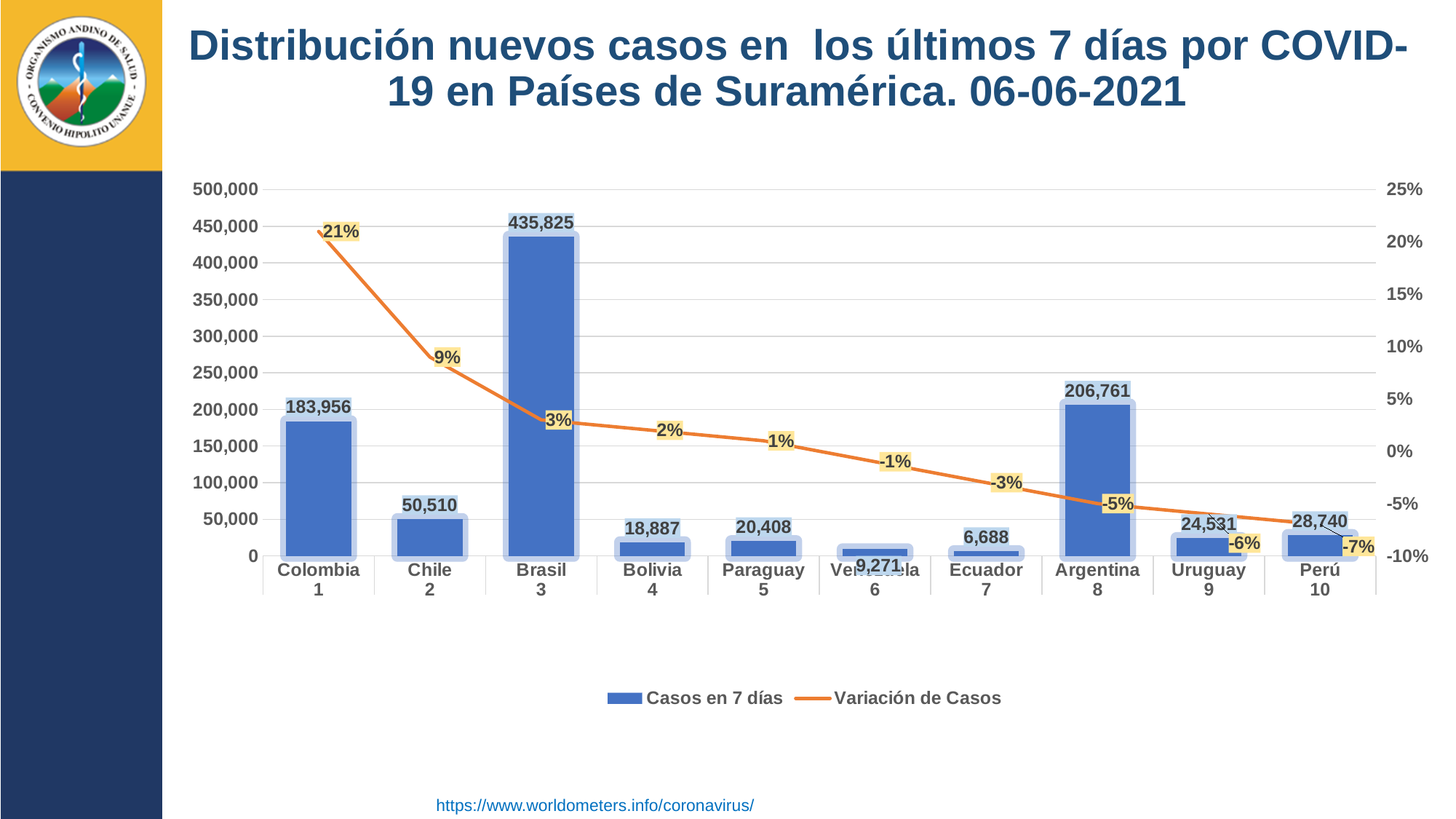
How many countries are shown on the x axis? 10 What is the 'Variación de Casos' value for Perú? -7% Which country has the highest number of 'Casos en 7 días'? Brasil What is the 'Variación de Casos' value for Colombia? 21% Which has more 'Casos en 7 días', Colombia or Argentina? Argentina What colour are the 'Casos en 7 días' bars? Blue Which country has the lowest number of 'Casos en 7 días'? Ecuador How many series does the legend list? 2 Does the 'Variación de Casos' line rise or fall from Colombia to Perú? fall What is the value of 'Casos en 7 días' for Brasil? 435,825 What is the difference in 'Casos en 7 días' between Brasil and Argentina? 229,064 What is the value of 'Casos en 7 días' for Argentina? 206,761